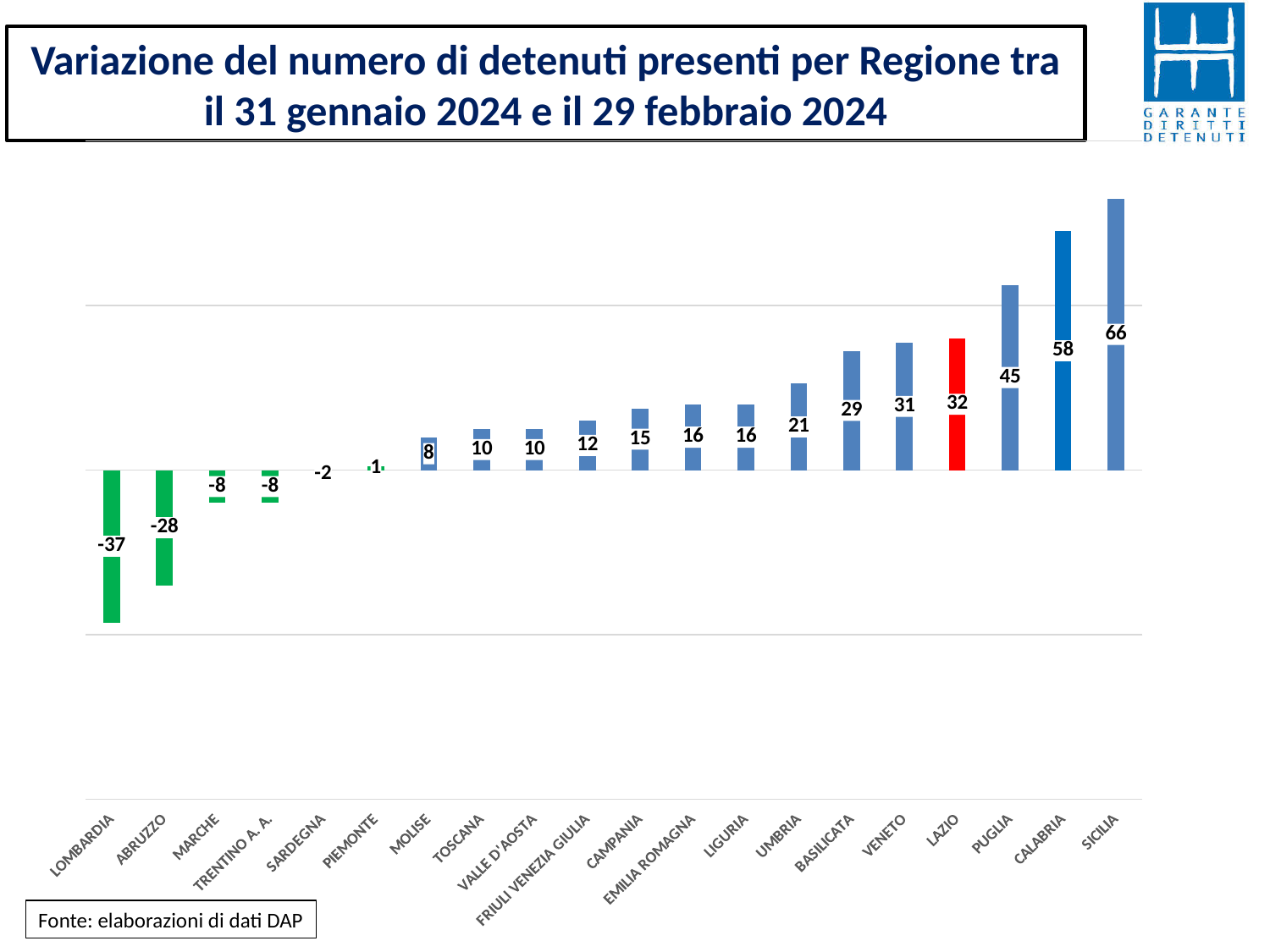
How many regions are shown in the chart? 20 What is the value for Umbria? 21 Which region has the highest value? Sicilia What is the value for Lombardia? -37 What is the difference between the values for Puglia and Lazio? 13 What is the difference between the values for Sicilia and Calabria? 8 Which has the larger value, Veneto or Basilicata? Veneto Which region has the lowest value? Lombardia What is the value for Lazio? 32 Do the values rise or fall from left to right along the x axis? Rise What kind of chart is shown on the slide? Bar chart Which has the larger value, Abruzzo or Marche? Marche